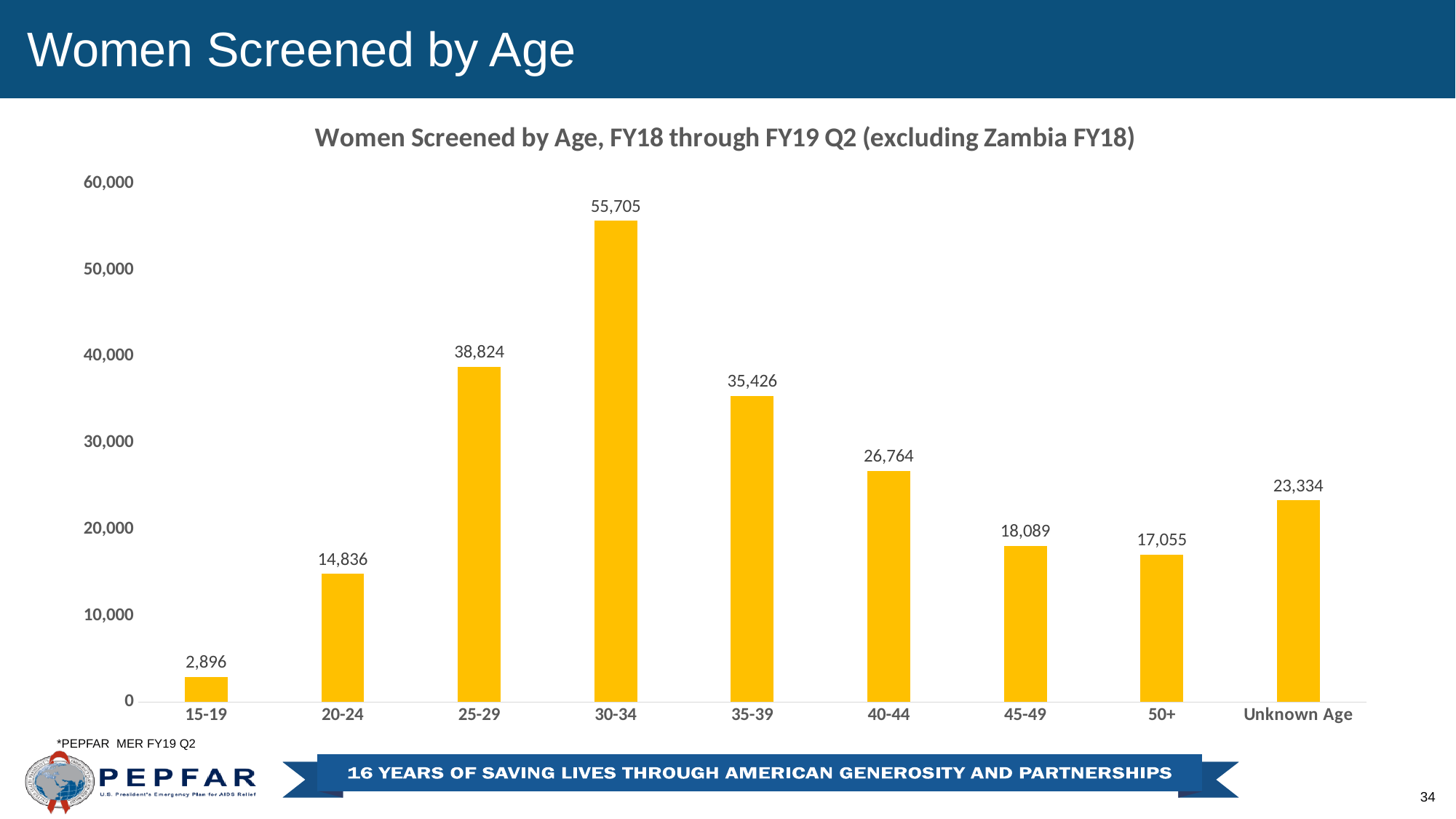
What is the difference between the 45-49 and 50+ age groups? 1,034 Which is larger, the value for 35-39 or the value for 40-44? 35-39 What is the title of the chart? Women Screened by Age, FY18 through FY19 Q2 (excluding Zambia FY18) How many age categories are shown on the x axis? 9 What is the value for the 15-19 age group? 2,896 What is the difference between the 30-34 and 25-29 age groups? 16,881 How many women of Unknown Age were screened? 23,334 Which age group has the highest number of women screened? 30-34 How many women aged 30-34 were screened? 55,705 Is the value for 20-24 greater or less than 20,000? less What kind of chart is shown on the slide? bar chart Which age group has the lowest number of women screened? 15-19